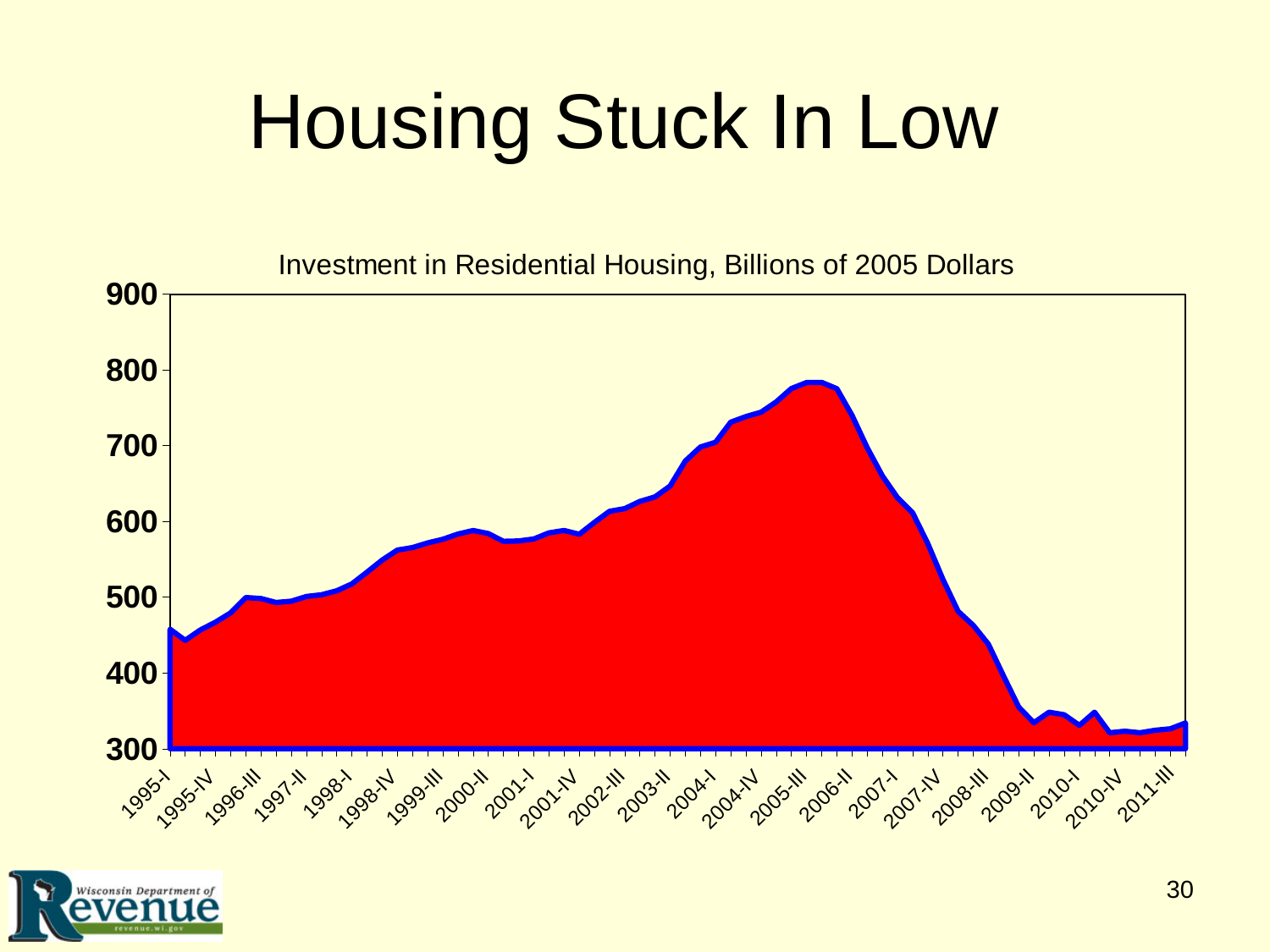
Is the value for 1995-I greater or less than 500? less Is the peak value of the series greater or less than 800? less Does the series rise or fall between 2006-II and 2009-II? fall Is the value for 2004-IV greater or less than 700? greater Which is larger, the value for 2005-III or the value for 2011-III? 2005-III Does the series generally rise or fall between 1995-I and 2005-III? rise What is the title of the chart? Investment in Residential Housing, Billions of 2005 Dollars What is the highest value shown on the vertical axis? 900 What kind of chart is shown on the slide? Area chart